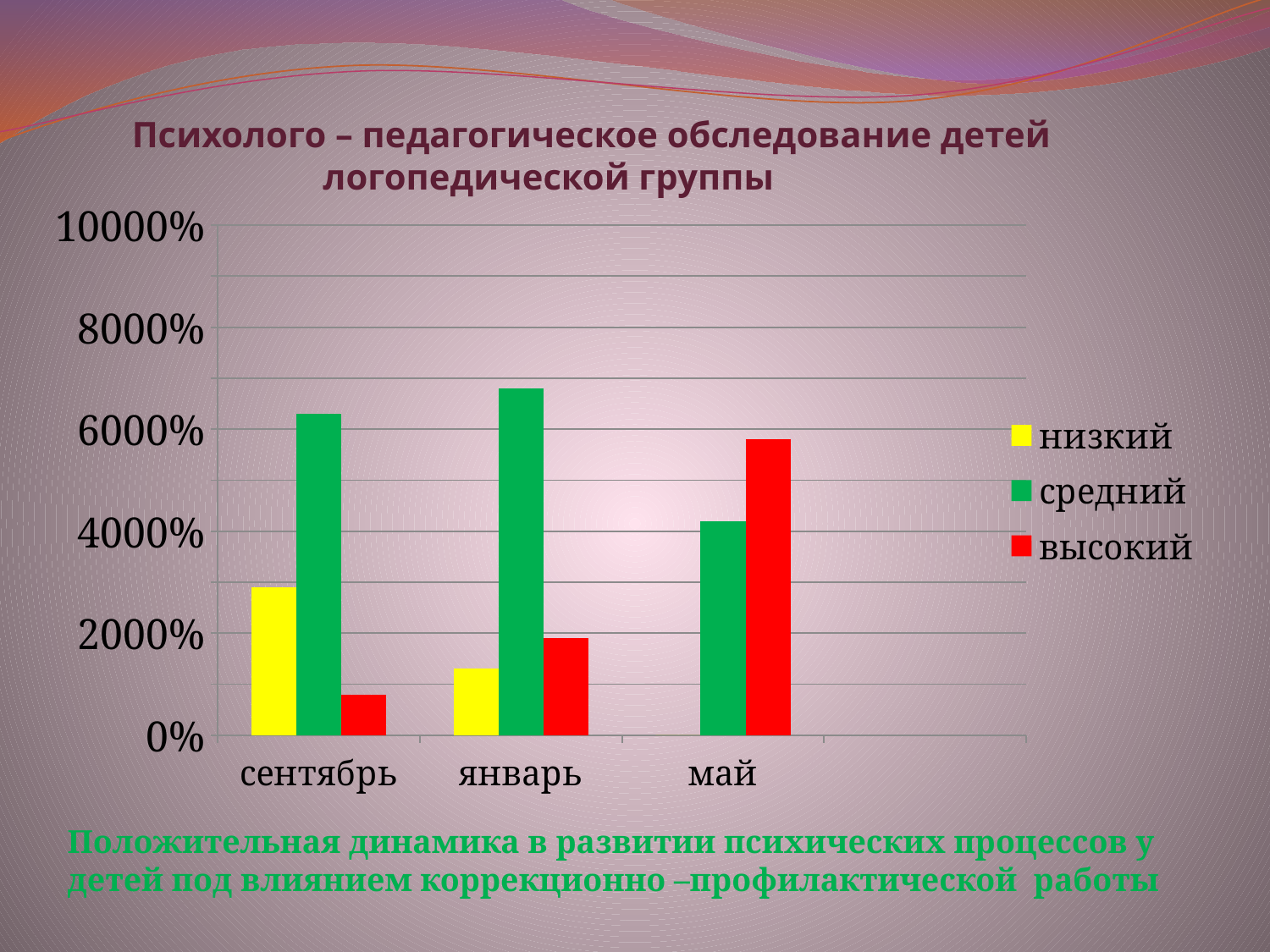
Is the value for средний in январь greater or less than 6000%? greater Which category has the lowest value for the средний series? май Which is larger in январь: the value for средний or the value for высокий? средний Which series is shown in red in the chart legend? высокий Is the value for высокий in сентябрь greater or less than 2000%? less Which category has the highest value for the высокий series? май Is the value for высокий in май greater or less than 4000%? greater How many series does the chart legend list? 3 Does the value for the высокий series rise or fall from сентябрь to май? rise How many categories are shown on the x axis of the chart? 3 What kind of chart is shown on the slide? bar chart